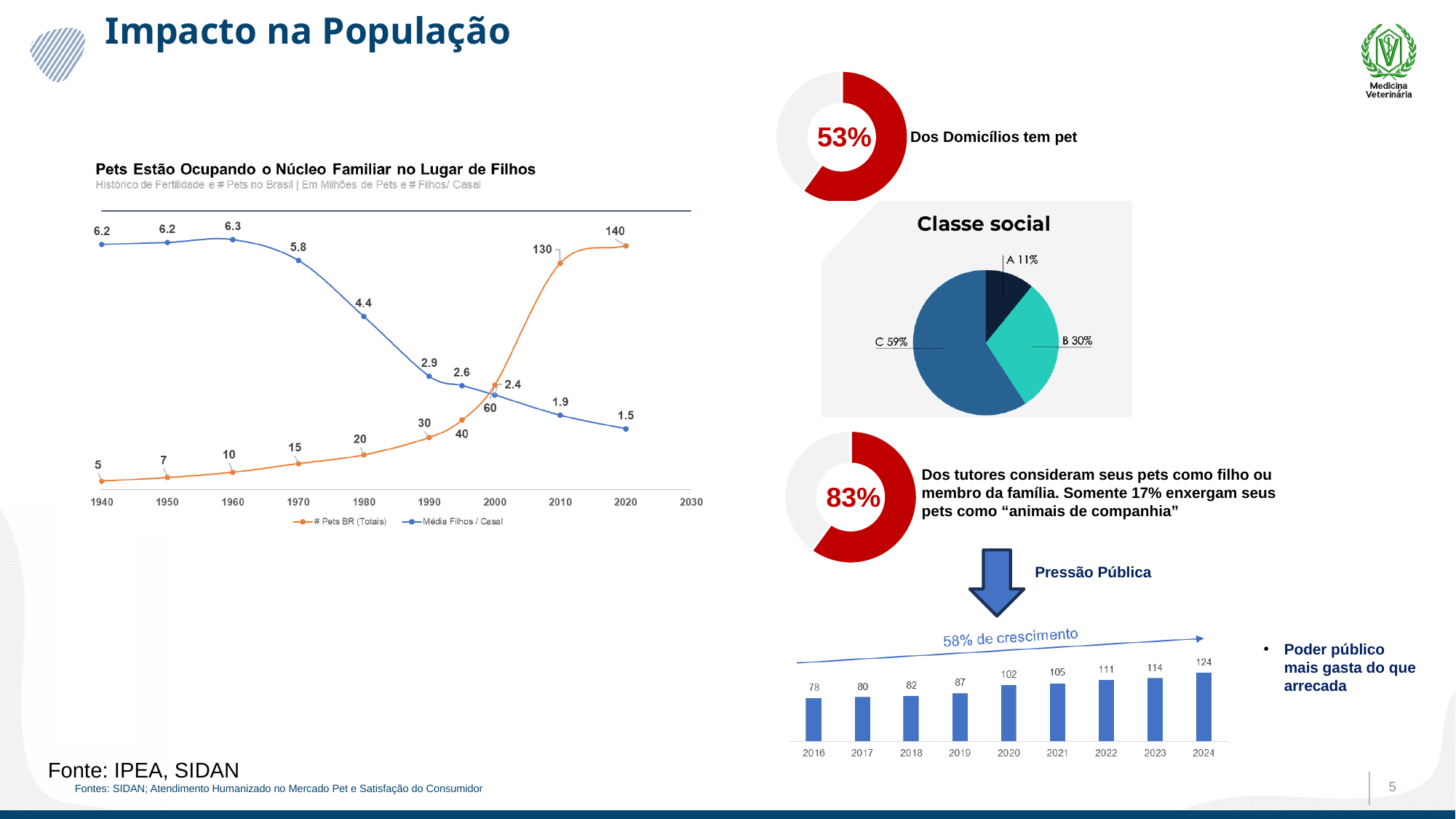
In the bar chart at the bottom right (2016–2024), what is the value for 2020? 102 In the line chart 'Pets Estão Ocupando o Núcleo Familiar no Lugar de Filhos', what is the value of 'Média Filhos / Casal' in 1980? 4.4 What kind of chart is the chart at the bottom right showing the years 2016 to 2024? bar chart In the line chart 'Pets Estão Ocupando o Núcleo Familiar no Lugar de Filhos', what is the difference between the '# Pets BR (Totais)' values for 2010 and 2000? 70 In the pie chart 'Classe social', which class has the smallest slice? A In the bar chart at the bottom right (2016–2024), which year has the highest value? 2024 How many bars are in the bar chart at the bottom right (2016–2024)? 9 In the line chart 'Pets Estão Ocupando o Núcleo Familiar no Lugar de Filhos', does the 'Média Filhos / Casal' series rise or fall from 1960 to 2020? fall How many series does the legend of the line chart 'Pets Estão Ocupando o Núcleo Familiar no Lugar de Filhos' list? 2 In the line chart 'Pets Estão Ocupando o Núcleo Familiar no Lugar de Filhos', what is the value of '# Pets BR (Totais)' in 2020? 140 In the bar chart at the bottom right (2016–2024), what is the difference between the values for 2024 and 2016? 46 In the pie chart 'Classe social', what share does class C have? 59%